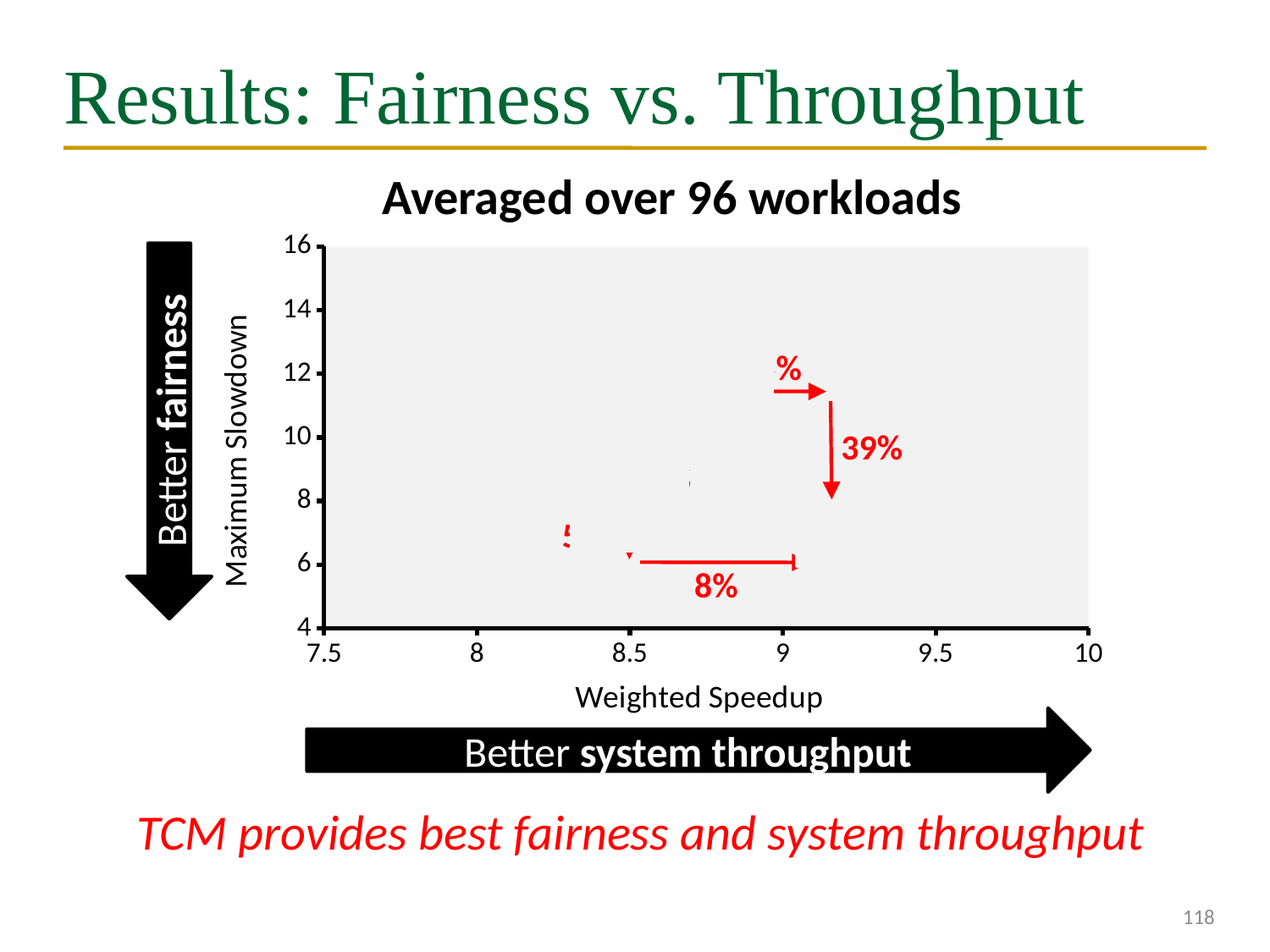
What percentage is printed next to the downward-pointing red arrow on the chart? 39% What is the title of the chart? Averaged over 96 workloads What is the label of the vertical axis of the chart? Maximum Slowdown What percentage is printed below the horizontal red arrow near the bottom of the chart? 8% What kind of chart is shown on the slide? scatter chart